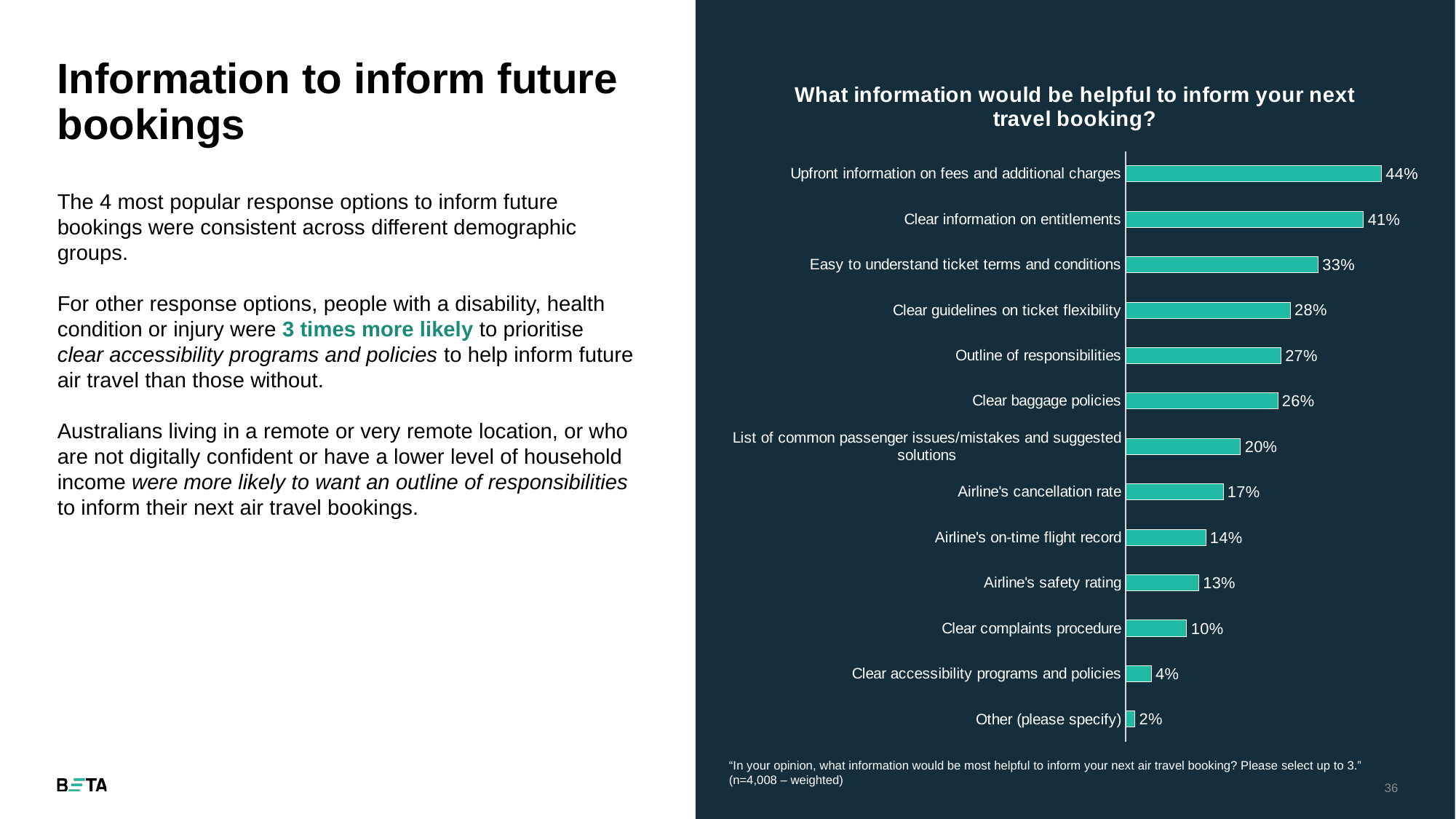
What is the difference between 'Clear complaints procedure' and 'Clear accessibility programs and policies'? 6% What is the difference between 'Clear information on entitlements' and 'Easy to understand ticket terms and conditions'? 8% What is the title of the chart? What information would be helpful to inform your next travel booking? What is the sample size (n) noted below the chart? n=4,008 – weighted Which response option has the highest value in the chart? Upfront information on fees and additional charges How many response options are shown in the chart? 13 What percentage of respondents selected 'Upfront information on fees and additional charges'? 44% What percentage is shown for 'Airline's safety rating'? 13% Which response option has the lowest value in the chart? Other (please specify) What is the value for 'Clear baggage policies'? 26% Which is larger: 'Airline's cancellation rate' or 'Airline's on-time flight record'? Airline's cancellation rate What type of chart is shown on the slide? Bar chart